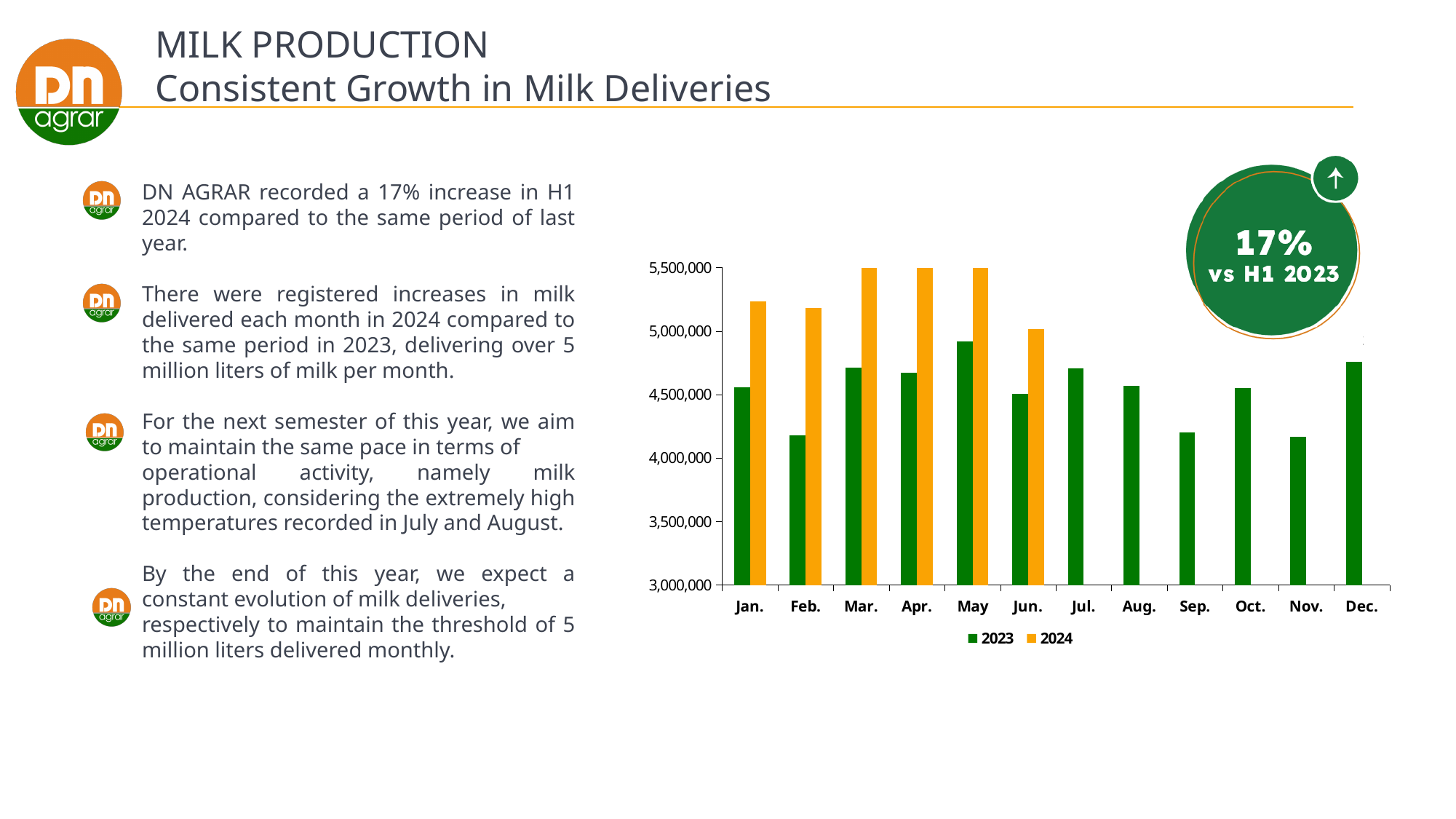
Is the 2024 value for Jan. greater or less than 5,000,000? greater For how many months does the chart show a 2024 bar? 6 How many months are shown on the x axis of the chart? 12 Is the 2023 value for Sep. greater or less than 4,500,000? less Which month has the highest 2023 value? May Which is larger for Jan., the 2023 value or the 2024 value? 2024 What kind of chart is shown on the slide? bar chart Do the 2023 values rise or fall from Jul. to Sep.? fall How many series does the chart legend list? 2 Is the 2023 value for Feb. greater or less than 4,500,000? less Which colour represents the 2024 series in the chart? orange